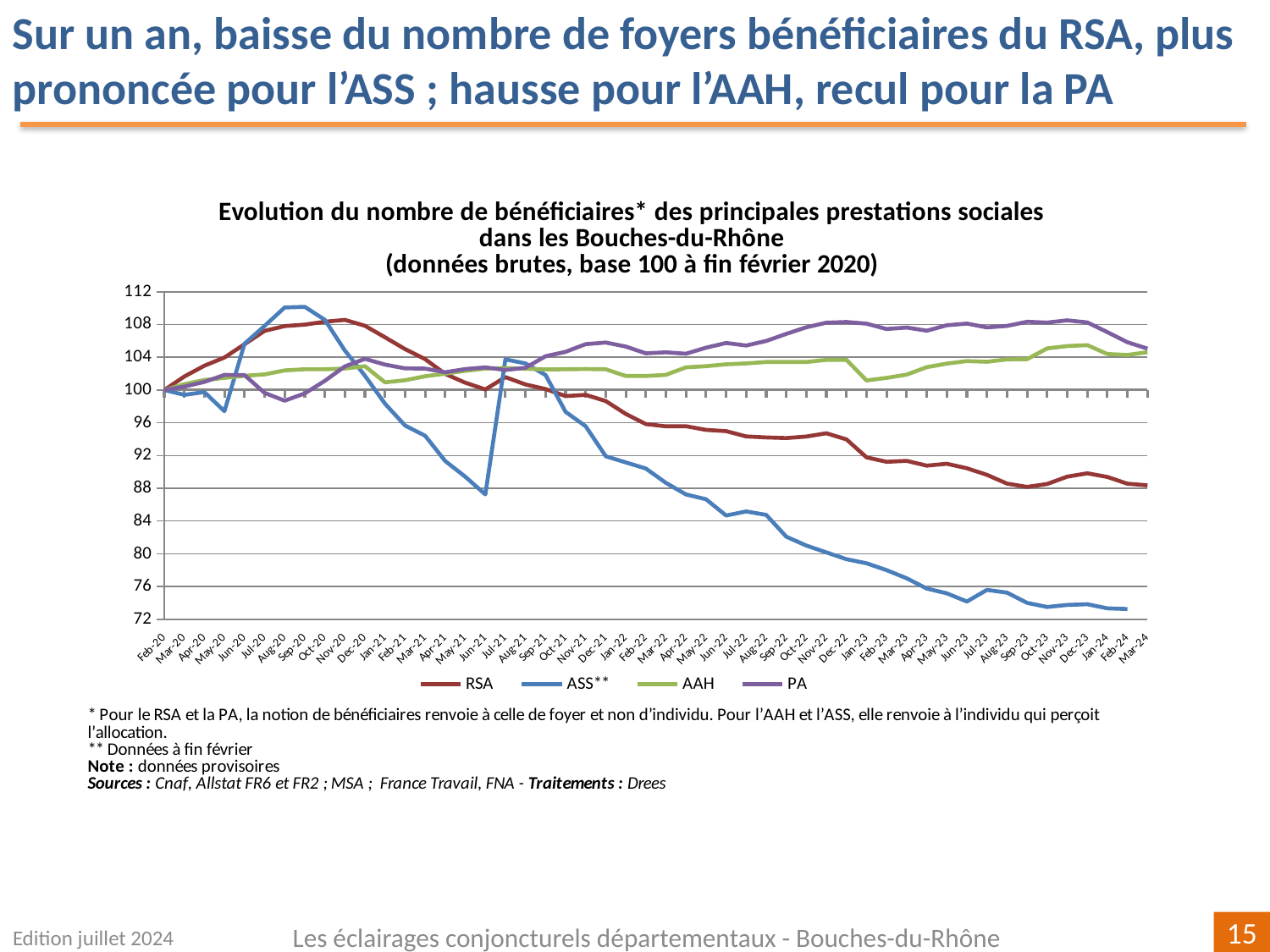
Does the PA series overall rise or fall from Feb-20 to Mar-24? rise Which colour is used for the RSA series in the chart? red How many series does the legend list? 4 Is the value for RSA at Mar-24 greater or less than 84? greater Which series has the highest value at Dec-22? PA Is the value for ASS** at Sep-20 greater or less than 108? greater Is the value for PA at Dec-22 greater or less than 104? greater Which series has the lowest value at Mar-24? RSA Does the ASS** series overall rise or fall from Feb-20 to Mar-24? fall What kind of chart is shown on the slide? line chart